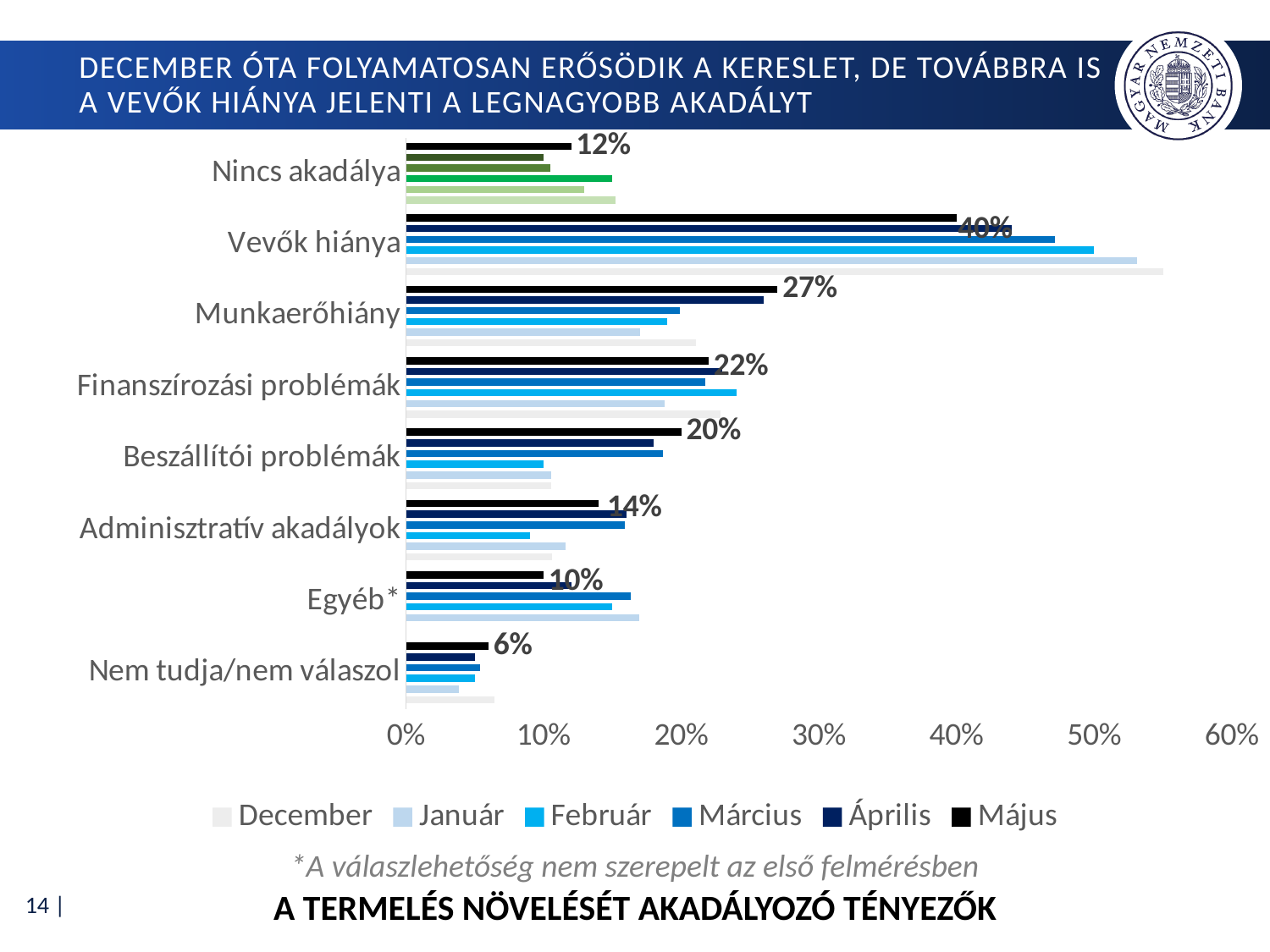
How many series does the legend list? 6 Which category has the lowest Május value? Nem tudja/nem válaszol How many categories are shown on the chart? 8 What is the difference between the Május values for Vevők hiánya and Munkaerőhiány? 13 percentage points Which has the larger Május value, Finanszírozási problémák or Beszállítói problémák? Finanszírozási problémák Is the December value for Vevők hiánya greater or less than 50%? greater What is the Május value for Nem tudja/nem válaszol? 6% Which category has the highest Május value? Vevők hiánya What is the Május value for Munkaerőhiány? 27% Is the December value for Nincs akadálya greater or less than 20%? less What is the Május value for Vevők hiánya? 40% What kind of chart is shown on the slide? bar chart